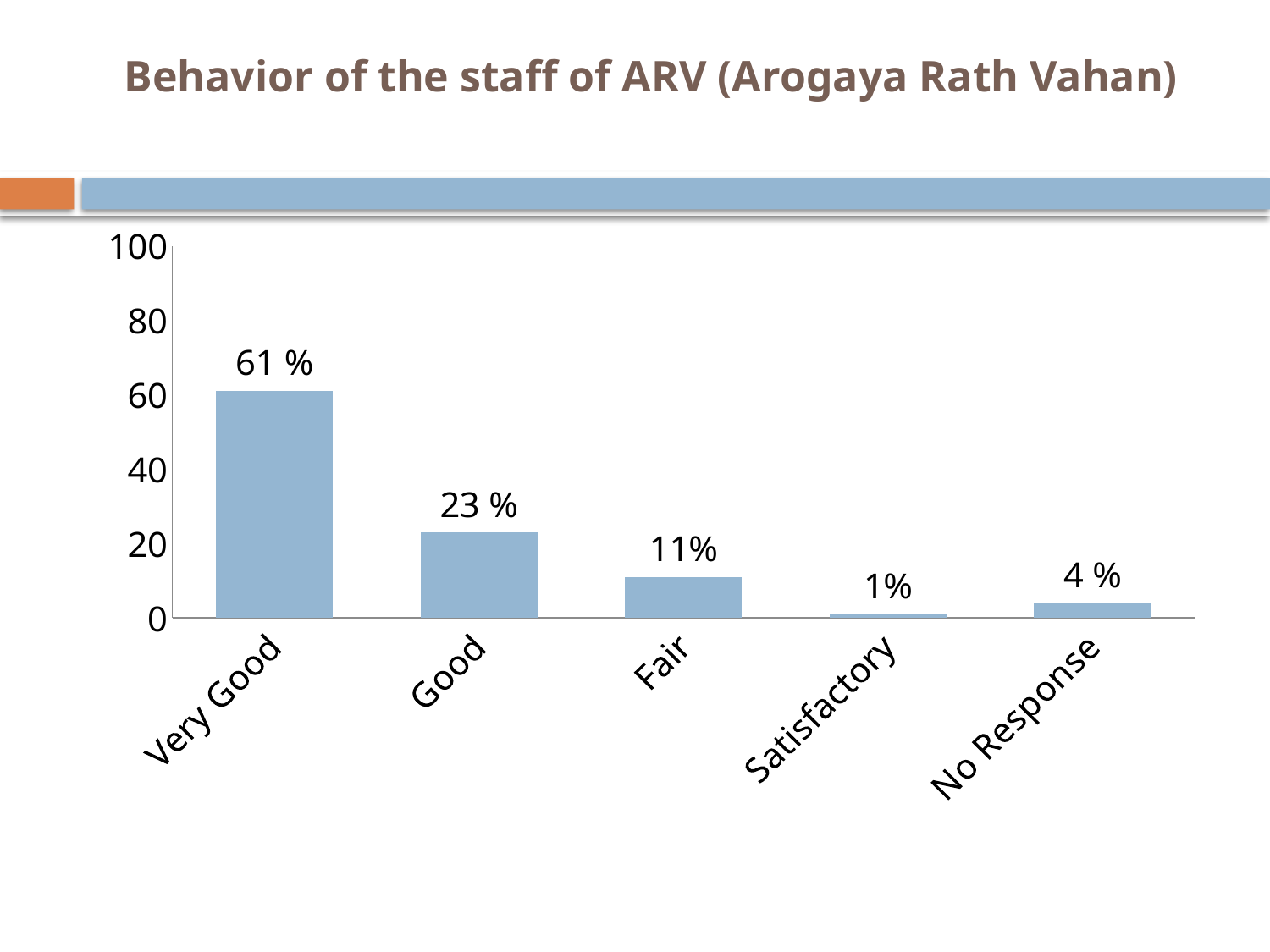
Which category has the highest value? Very Good What is the value for Good? 23 % How many categories are shown on the x axis? 5 What is the title of the slide? Behavior of the staff of ARV (Arogaya Rath Vahan) What is the value for Fair? 11% Which is larger, the value for Fair or the value for No Response? Fair What is the value for No Response? 4 % What is the value for Very Good? 61 % What kind of chart is shown on the slide? Bar chart Which category has the lowest value? Satisfactory What is the value for Satisfactory? 1% What is the difference between the values for Very Good and Good? 38 %